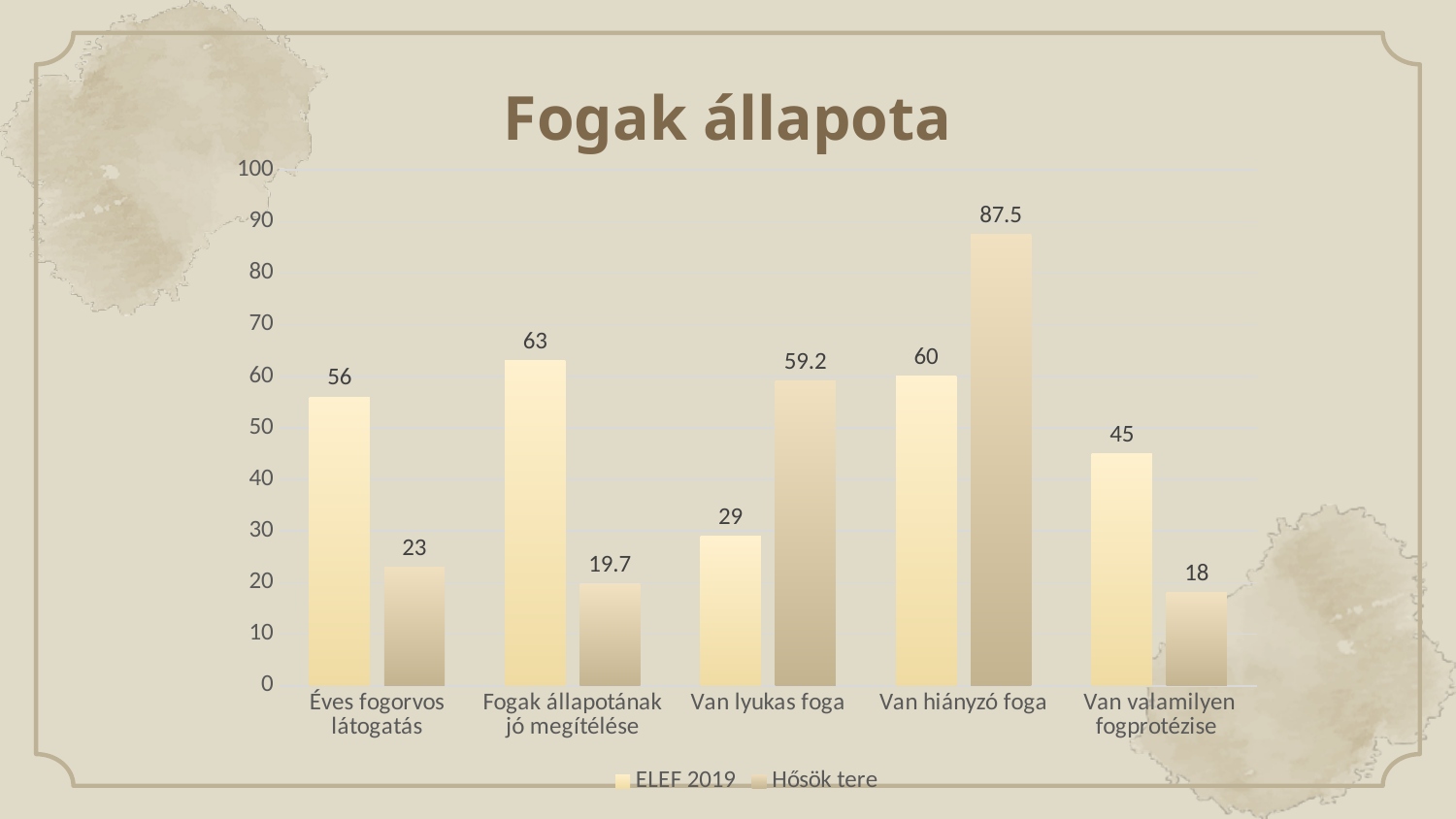
Which is larger for 'Van valamilyen fogprotézise': ELEF 2019 or Hősök tere? ELEF 2019 What is the value for Hősök tere in the 'Fogak állapotának jó megítélése' category? 19.7 How many series does the legend list? 2 What kind of chart is shown on the slide? Bar chart What is the value for ELEF 2019 in the 'Éves fogorvos látogatás' category? 56 What is the title of the chart? Fogak állapota Which category has the highest Hősök tere value? Van hiányzó foga What is the value for Hősök tere in the 'Van hiányzó foga' category? 87.5 Which category has the lowest ELEF 2019 value? Van lyukas foga What is the difference between the ELEF 2019 and Hősök tere values for 'Van lyukas foga'? 30.2 What is the difference between the Hősök tere values for 'Van hiányzó foga' and 'Van valamilyen fogprotézise'? 69.5 How many categories are shown on the x axis? 5